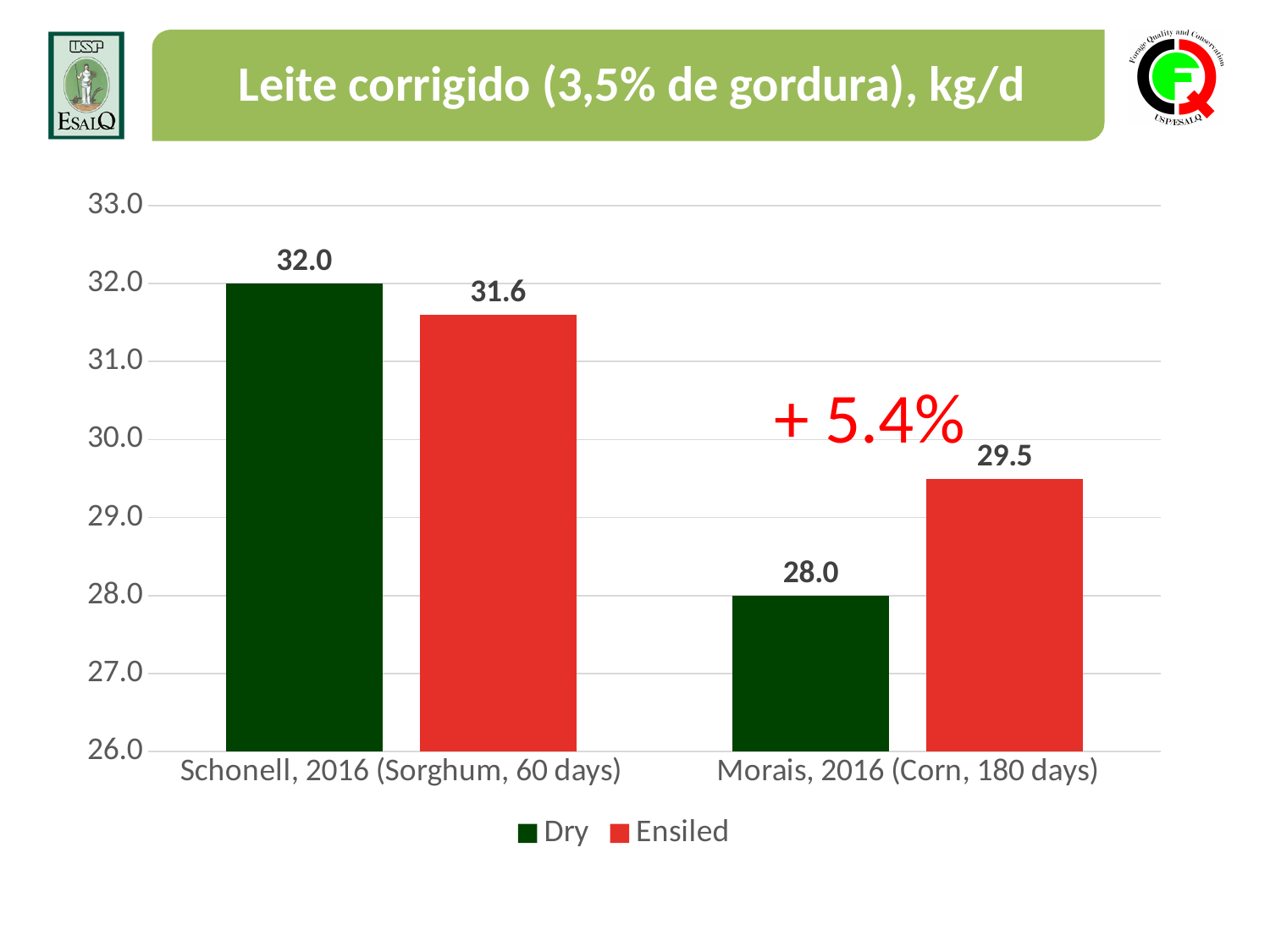
What is the Dry value for Morais, 2016 (Corn, 180 days)? 28.0 Which bar has the lowest value on the chart? Dry, Morais, 2016 (Corn, 180 days) What is the Ensiled value for Morais, 2016 (Corn, 180 days)? 29.5 How many categories are shown on the x axis? 2 For Schonell, 2016 (Sorghum, 60 days), which is larger: Dry or Ensiled? Dry What is the difference between the Ensiled and Dry values for Morais, 2016 (Corn, 180 days)? 1.5 What is the Ensiled value for Schonell, 2016 (Sorghum, 60 days)? 31.6 How many series does the legend list? 2 What kind of chart is shown on the slide? Bar chart Which bar has the highest value on the chart? Dry, Schonell, 2016 (Sorghum, 60 days) What is the Dry value for Schonell, 2016 (Sorghum, 60 days)? 32.0 What is the title of the chart? Leite corrigido (3,5% de gordura), kg/d